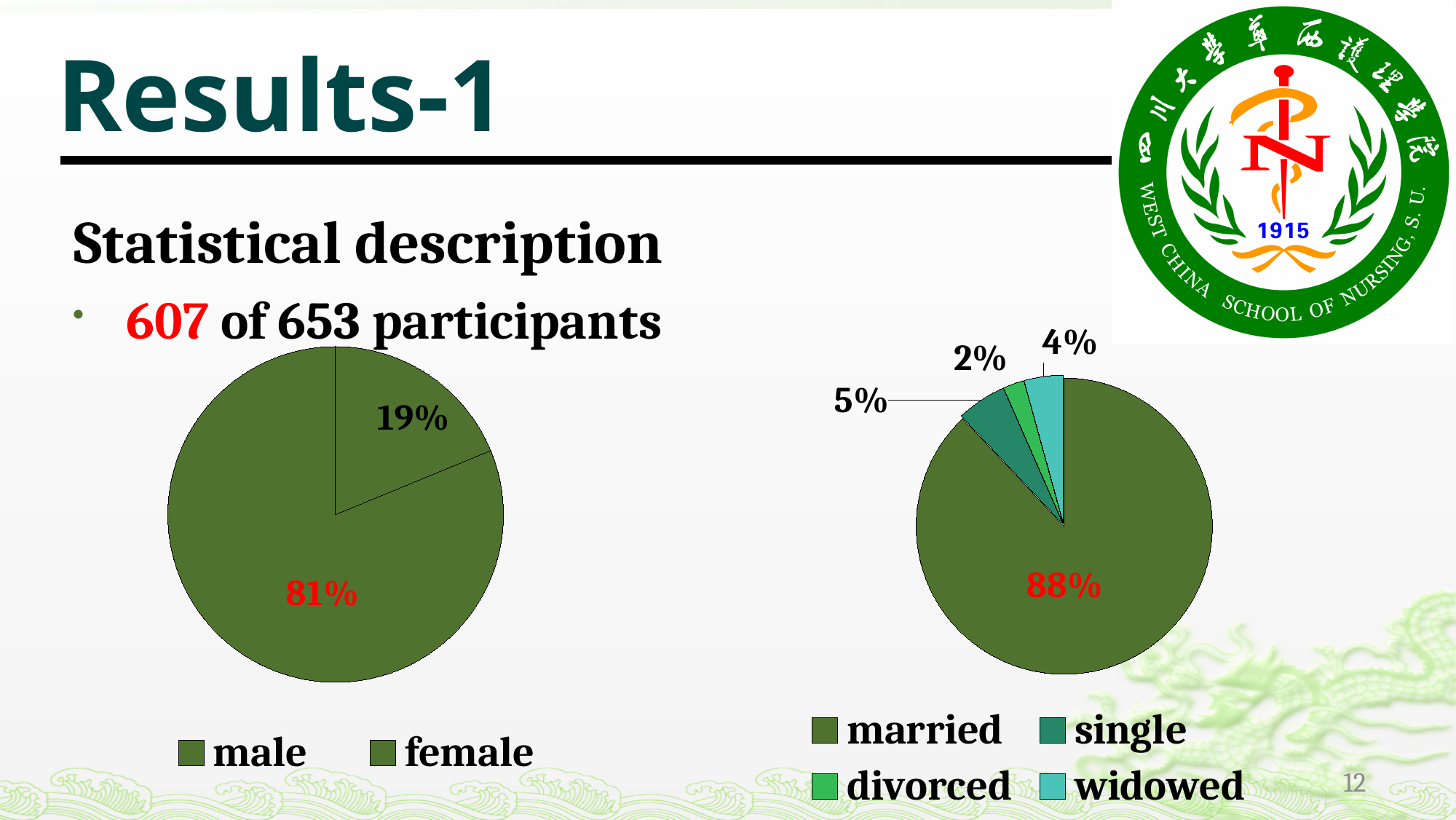
In the right chart, what share of participants are married? 88% How many categories does the legend of the right chart list? 4 In the right chart, what share of participants are divorced? 2% In the right chart, what share of participants are widowed? 4% In the left chart, what is the percentage shown on the larger slice? 81% In the right chart, which marital status category has the largest share? married In the right chart, what share of participants are single? 5% What kind of chart is the right chart (marital status)? pie chart In the right chart, what is the difference between the single and widowed shares? 1% What kind of chart is the left chart (male/female)? pie chart In the right chart, which marital status category has the smallest share? divorced In the right chart, which is larger, the widowed share or the divorced share? widowed